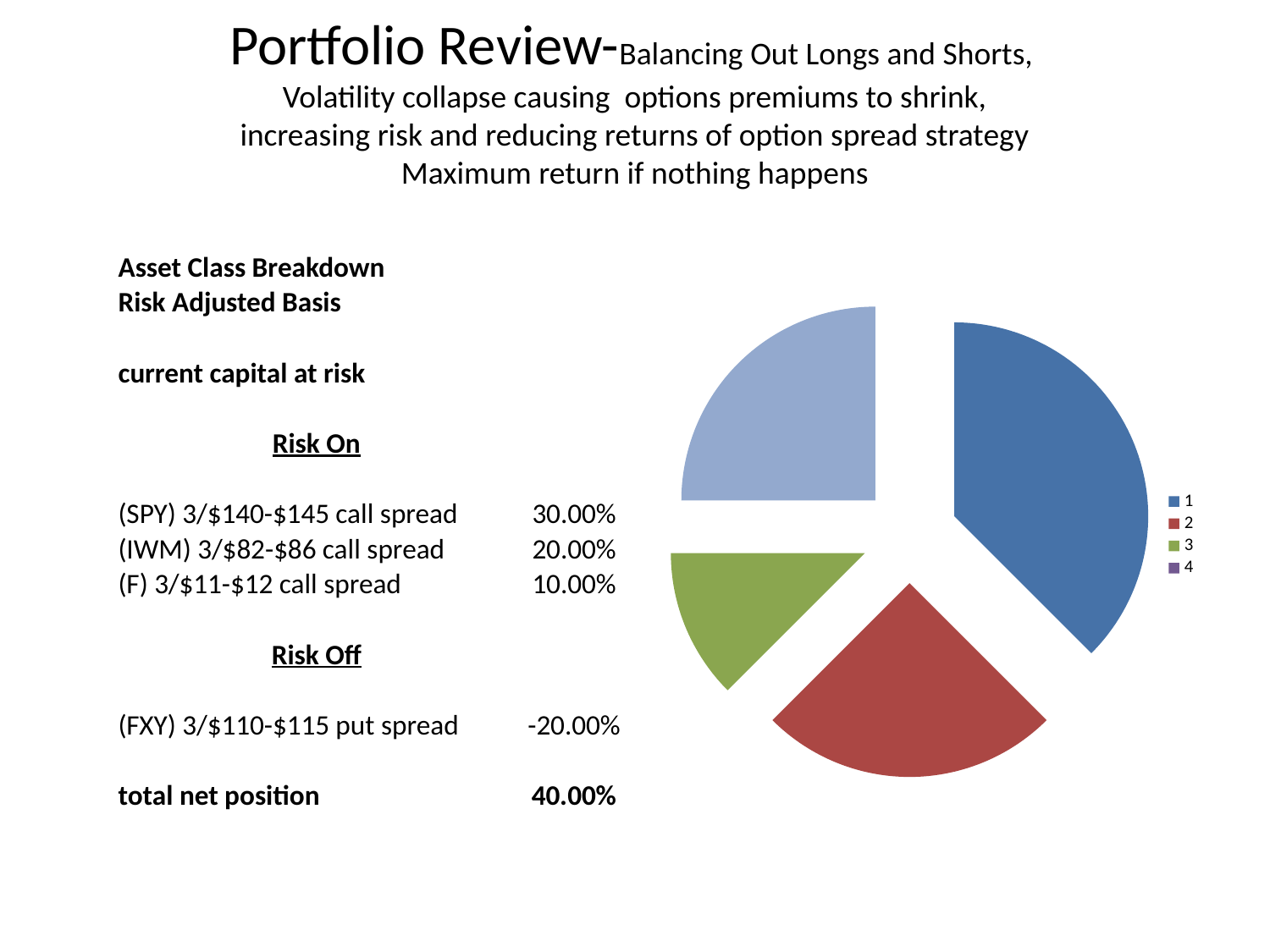
How many slices does the pie chart have? 4 In the pie chart, which slice is larger, 2 or 3? 2 Which slice of the pie chart is the smallest? 3 How many entries does the pie chart's legend list? 4 What kind of chart is shown on the slide? pie chart Which slice of the pie chart is the largest? 1 In the pie chart, which slice is larger, 1 or 2? 1 What colour is slice 1 in the pie chart? blue What colour is slice 2 in the pie chart? red